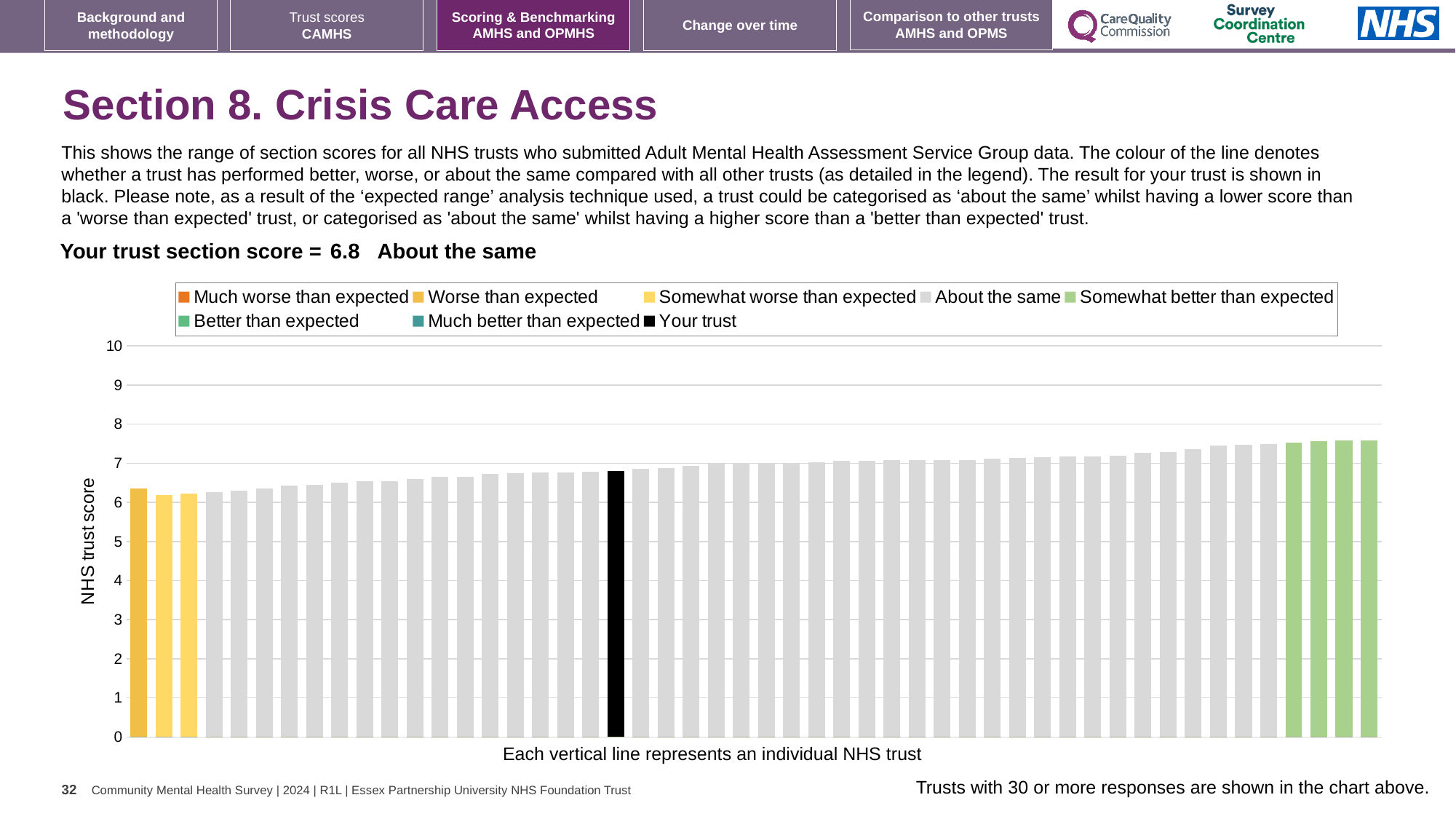
What colour is used for the bar representing your trust? black Do the bar values rise or fall from left to right along the x axis? rise Is the value for your trust (the black bar) greater or less than 5? greater Is the black bar for your trust taller or shorter than the first (leftmost) bar? taller Is the shortest bar in the chart greater or less than 5? greater Which category is your trust placed in for this section? About the same What kind of chart is shown on the slide? bar chart How many entries does the chart legend list? 8 What is the section score for your trust shown on the slide? 6.8 What is the label on the vertical axis of the chart? NHS trust score How many bars are coloured green (Somewhat better than expected)? 4 Is the tallest bar in the chart greater or less than 8? less